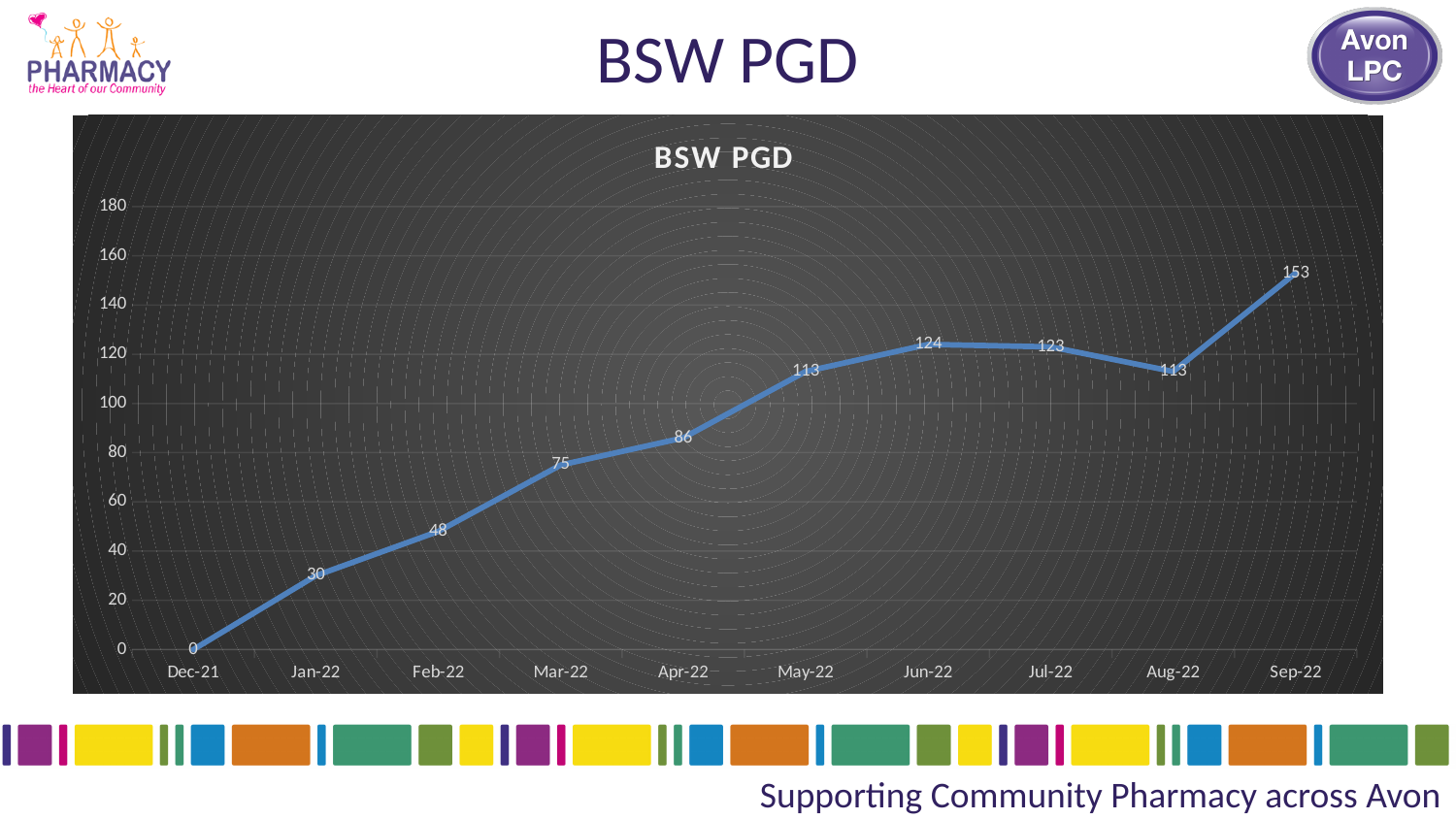
Which month has the highest value? Sep-22 What type of chart is shown on the slide? line chart What is the title of the chart? BSW PGD Is the value for May-22 greater or less than 100? greater Do the values generally rise or fall from Dec-21 to May-22? rise What is the value for Jun-22? 124 What is the value for Mar-22? 75 Which is larger, the value for Feb-22 or the value for Apr-22? Apr-22 What is the difference between the values for Sep-22 and Aug-22? 40 How many data points are plotted on the chart? 10 What is the value for Dec-21? 0 Which month has the lowest value? Dec-21